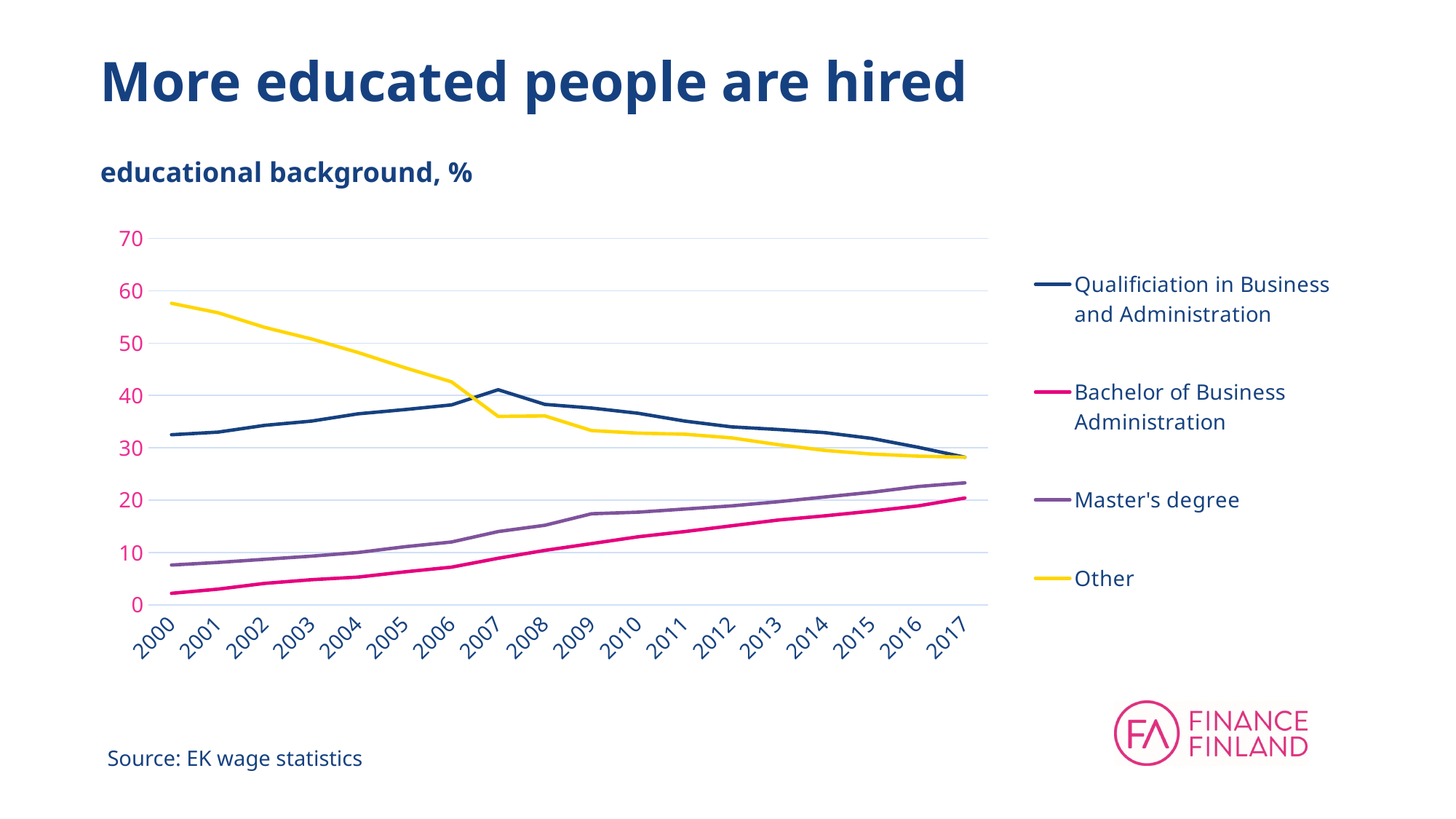
How many years are shown on the x axis? 18 Does the value for Other rise or fall from 2000 to 2017? fall Is the value for Bachelor of Business Administration in 2000 greater or less than 10? less In 2000, which is larger: Other or Qualificiation in Business and Administration? Other Does the value for Bachelor of Business Administration rise or fall from 2000 to 2017? rise Is the value for Other in 2000 greater or less than 50? greater What is the source given for the chart? EK wage statistics Is the value for Master's degree in 2017 greater or less than 20? greater What kind of chart is shown on the slide? line chart Does the value for Master's degree rise or fall from 2000 to 2017? rise How many series does the legend list? 4 Which series has the lowest value in 2017? Bachelor of Business Administration